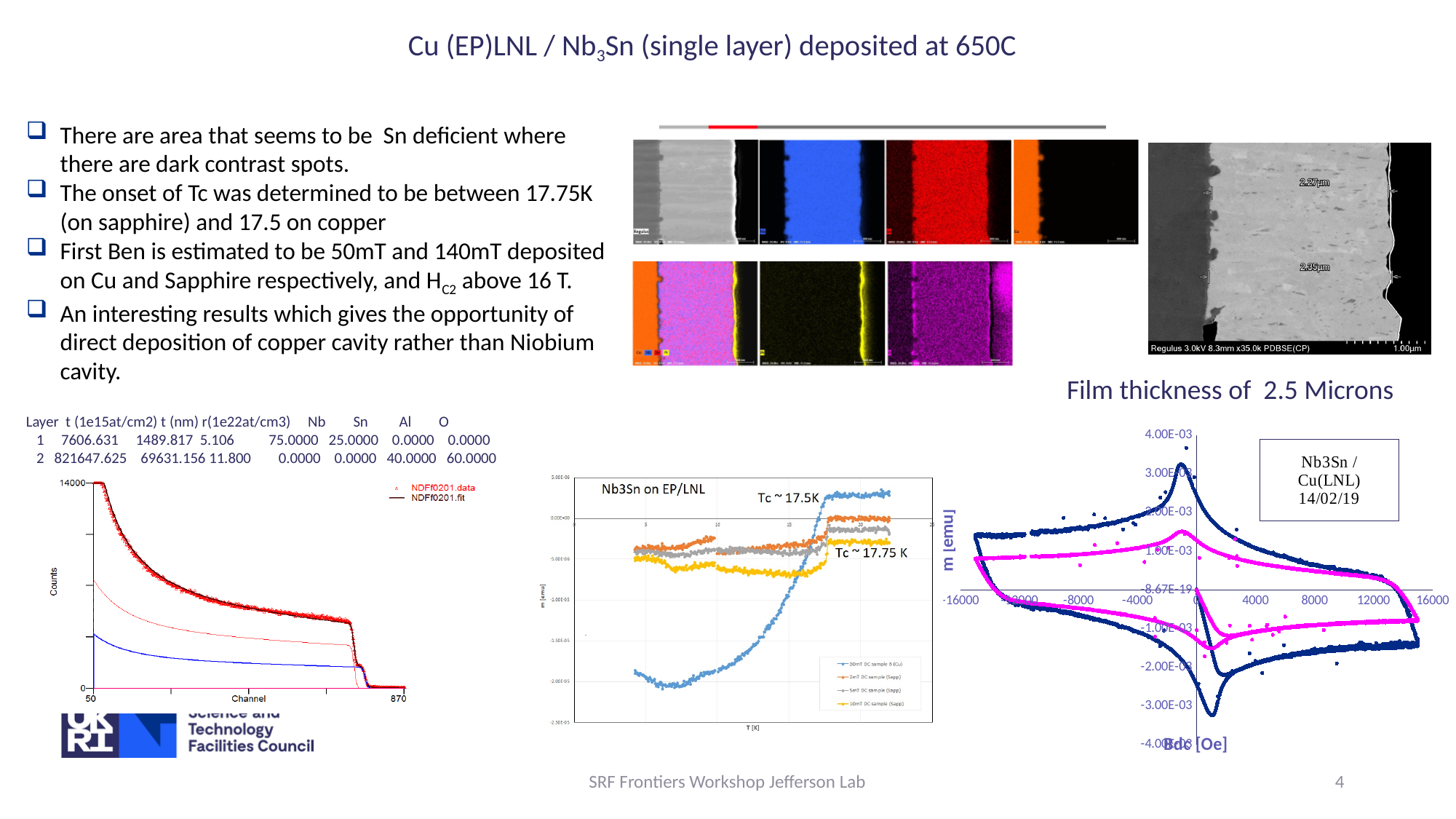
What is the title of the middle chart showing magnetic moment versus temperature? Nb3Sn on EP/LNL In the right-hand chart labelled 'Nb3Sn / Cu(LNL) 14/02/19', what are the minimum and maximum tick values on the x axis? -16000 and 16000 In the bottom-left chart of Counts versus Channel, do the counts rise or fall as the channel increases? fall In the middle chart titled 'Nb3Sn on EP/LNL', what quantity is plotted on the x axis? T [K] In the middle chart titled 'Nb3Sn on EP/LNL', what Tc value is annotated for the sample on copper (the blue curve)? Tc ~ 17.5K In the middle chart titled 'Nb3Sn on EP/LNL', how many series does the legend list? 4 In the bottom-left chart of Counts versus Channel, how many entries does the legend list? 2 In the middle chart titled 'Nb3Sn on EP/LNL', what Tc value is annotated for the samples on sapphire? Tc ~ 17.75 K